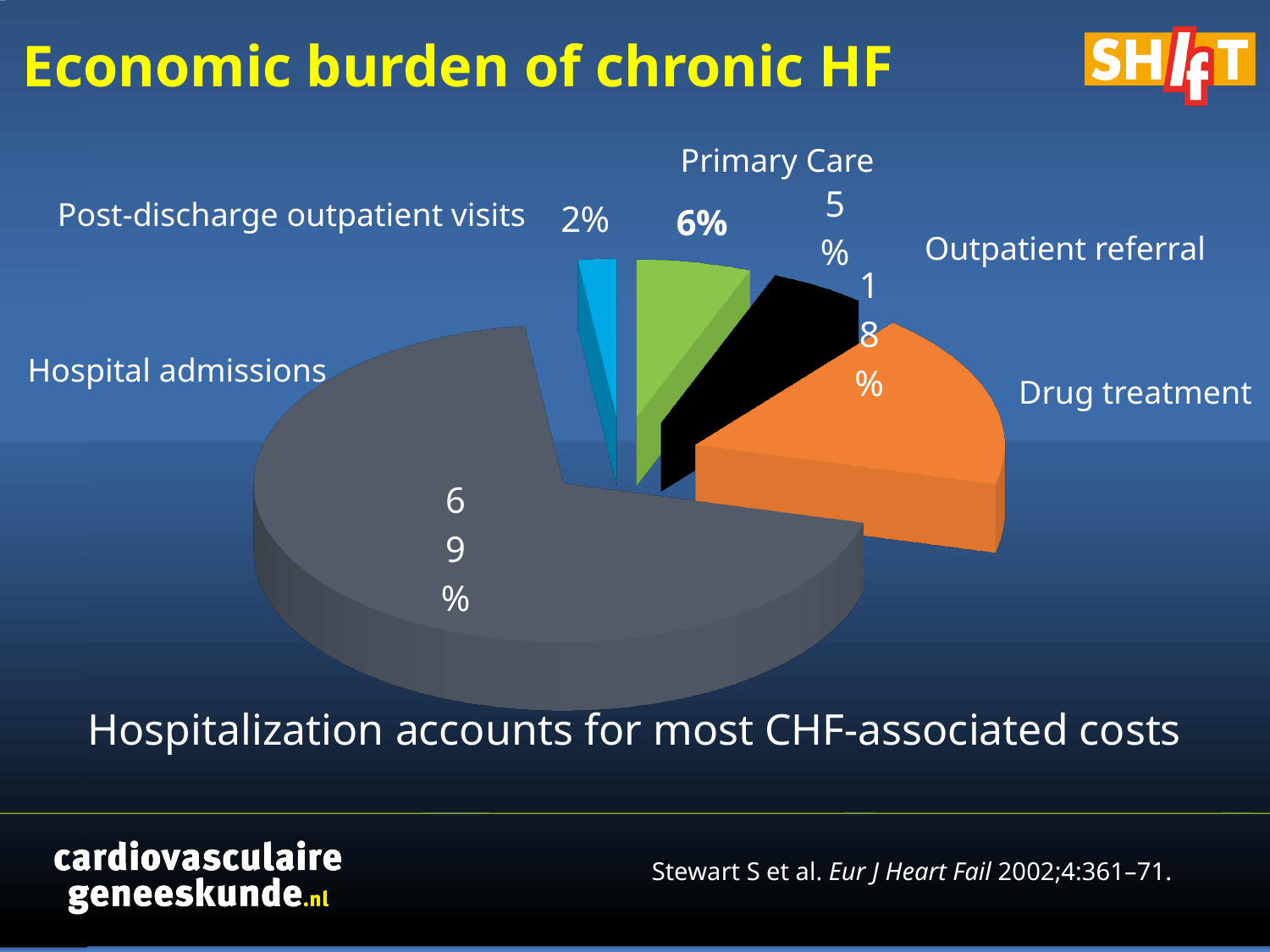
What share of costs is attributed to Hospital admissions? 69% What share of costs is attributed to Post-discharge outpatient visits? 2% What is the difference in percentage points between Hospital admissions and Drug treatment? 51 Which category accounts for the smallest share of the pie? Post-discharge outpatient visits How many categories are shown in the pie chart? 5 What share of costs is attributed to Primary Care? 6% What share of costs is attributed to Outpatient referral? 5% Which category accounts for the largest share of the pie? Hospital admissions What share of costs is attributed to Drug treatment? 18% What is the title of the slide containing the pie chart? Economic burden of chronic HF What kind of chart is shown on the slide? pie chart Which is larger, the share for Primary Care or the share for Outpatient referral? Primary Care